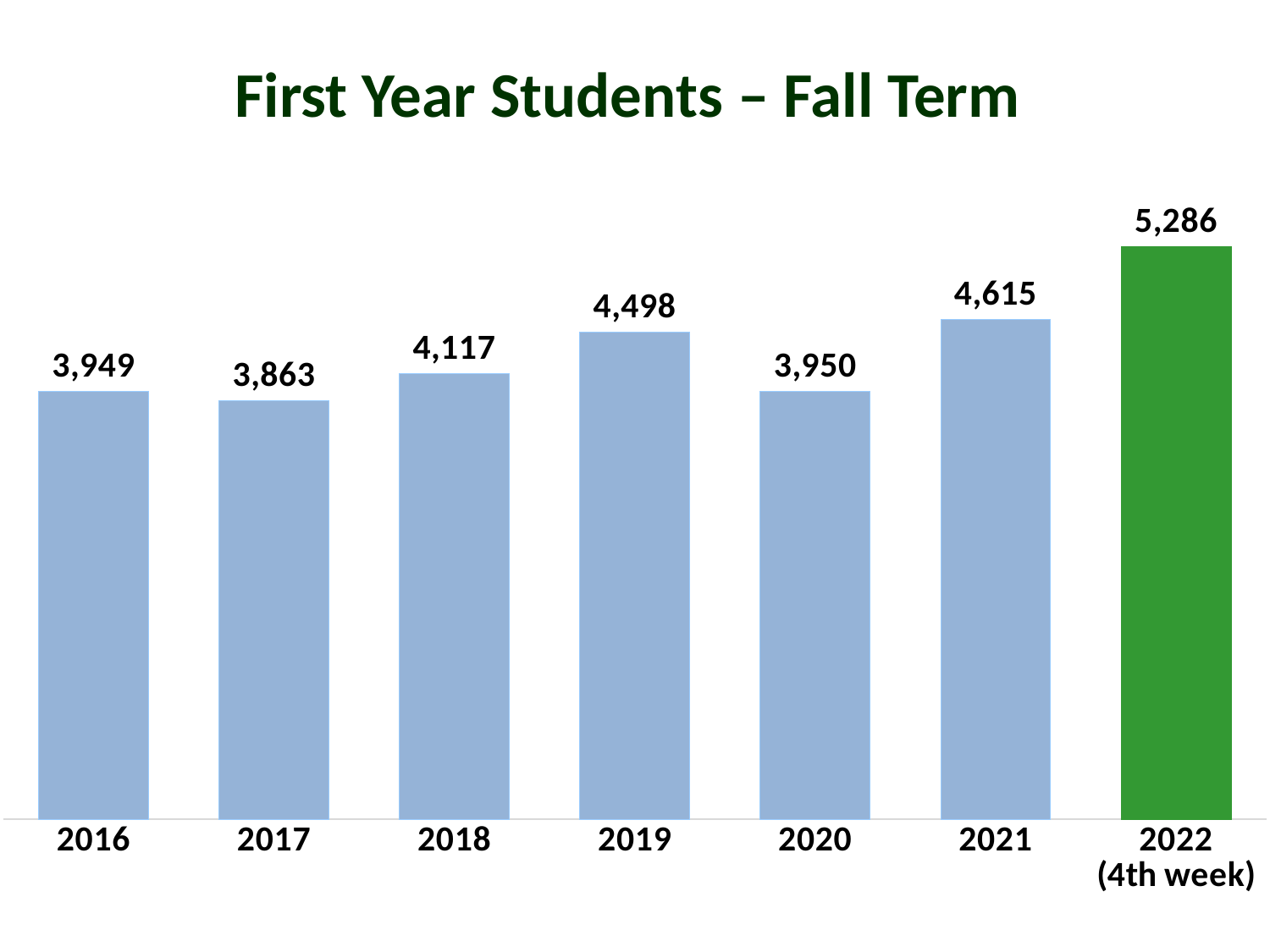
Which year has the lowest number of first year students? 2017 What is the title of the chart? First Year Students – Fall Term What kind of chart is shown on the slide? bar chart Which is larger, the value for 2018 or the value for 2020? 2018 What is the number of first year students in 2019? 4,498 What is the number of first year students in 2017? 3,863 Which year has the highest number of first year students? 2022 (4th week) How many years are shown on the chart? 7 What is the difference between the 2019 value and the 2018 value? 381 What is the number of first year students in 2022 (4th week)? 5,286 What is the difference between the 2022 (4th week) value and the 2021 value? 671 Which bar is coloured green rather than blue? 2022 (4th week)